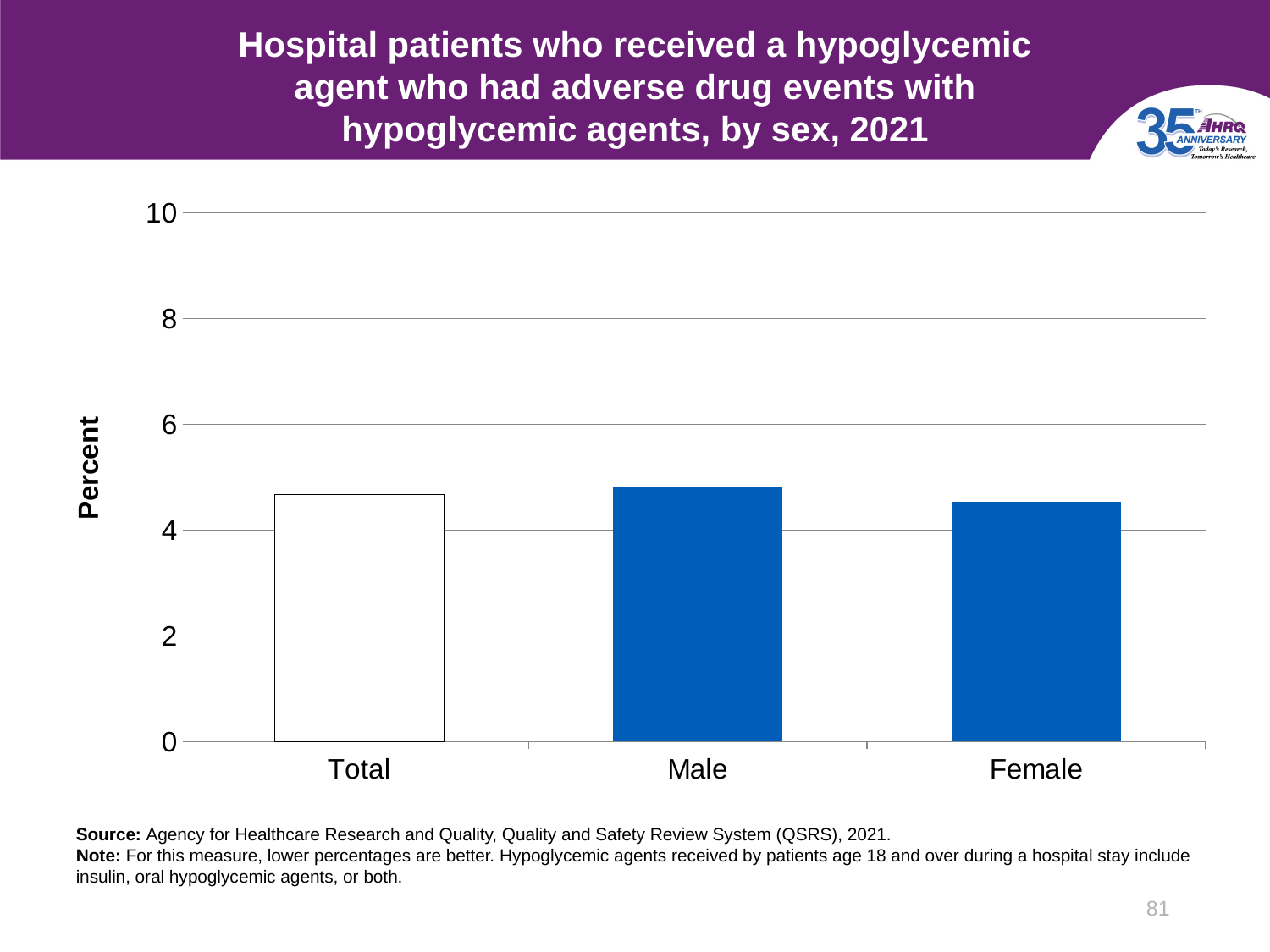
Is the value for Male greater or less than 6? less What is the maximum value shown on the y axis of the chart? 10 Which is larger, the value for Male or the value for Female? Male Which category is shown first on the x axis? Total What kind of chart is shown on the slide? bar chart How many categories are shown on the x axis of the chart? 3 Is the value for Female greater or less than 6? less Is the value for Male greater or less than 4? greater What is the label on the y axis of the chart? Percent